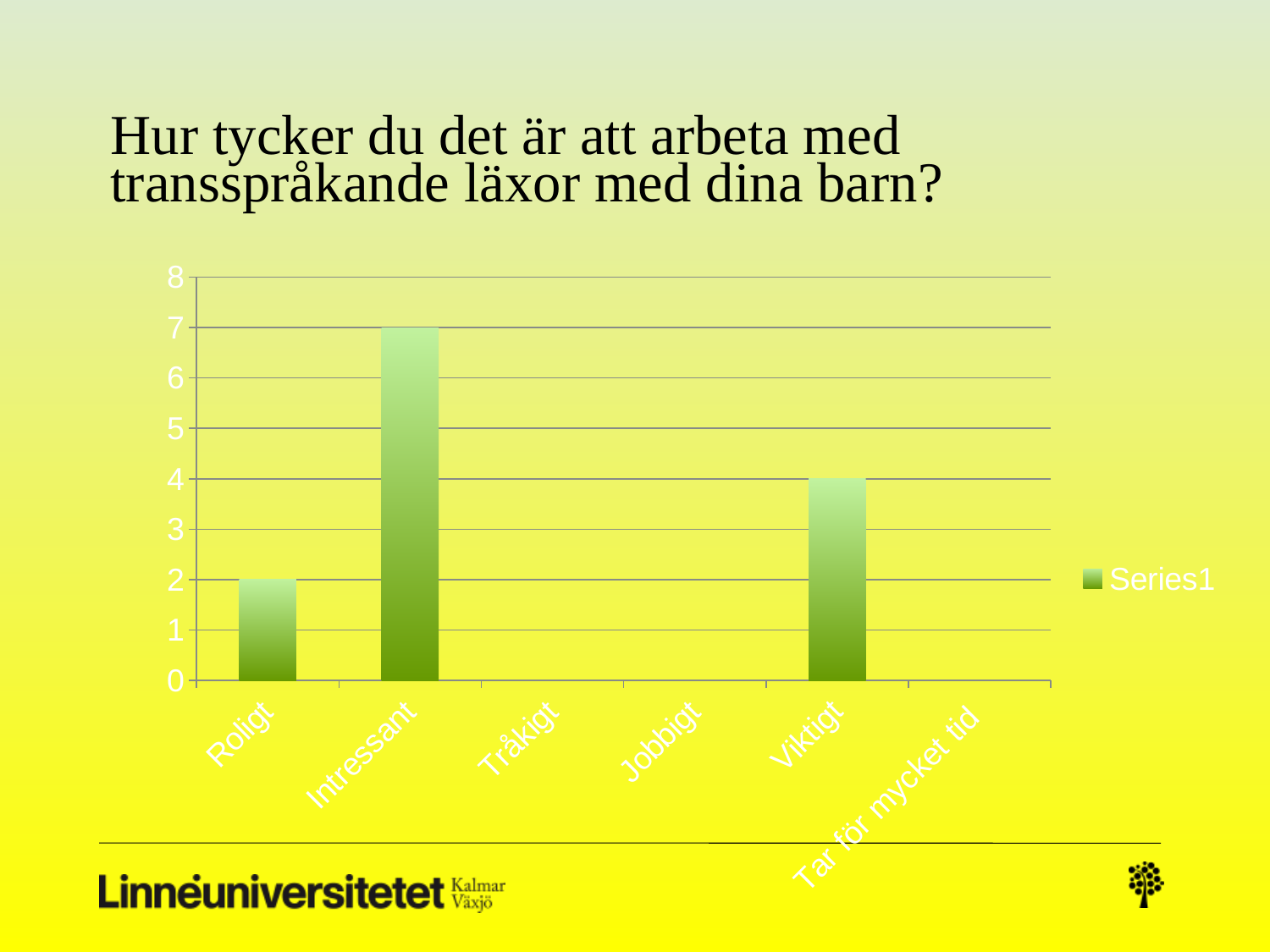
How many series does the legend list? 1 What is the difference between the values for Viktigt and Roligt? 2 What is the value for Intressant? 7 What kind of chart is shown on the slide? bar chart How many categories are shown on the x axis? 6 What is the difference between the values for Intressant and Viktigt? 3 What is the value for Viktigt? 4 Which is larger, the value for Roligt or the value for Viktigt? Viktigt Which category has the highest value? Intressant What is the name of the series shown in the legend? Series1 Is the value for Intressant greater or less than 5? greater What is the value for Roligt? 2